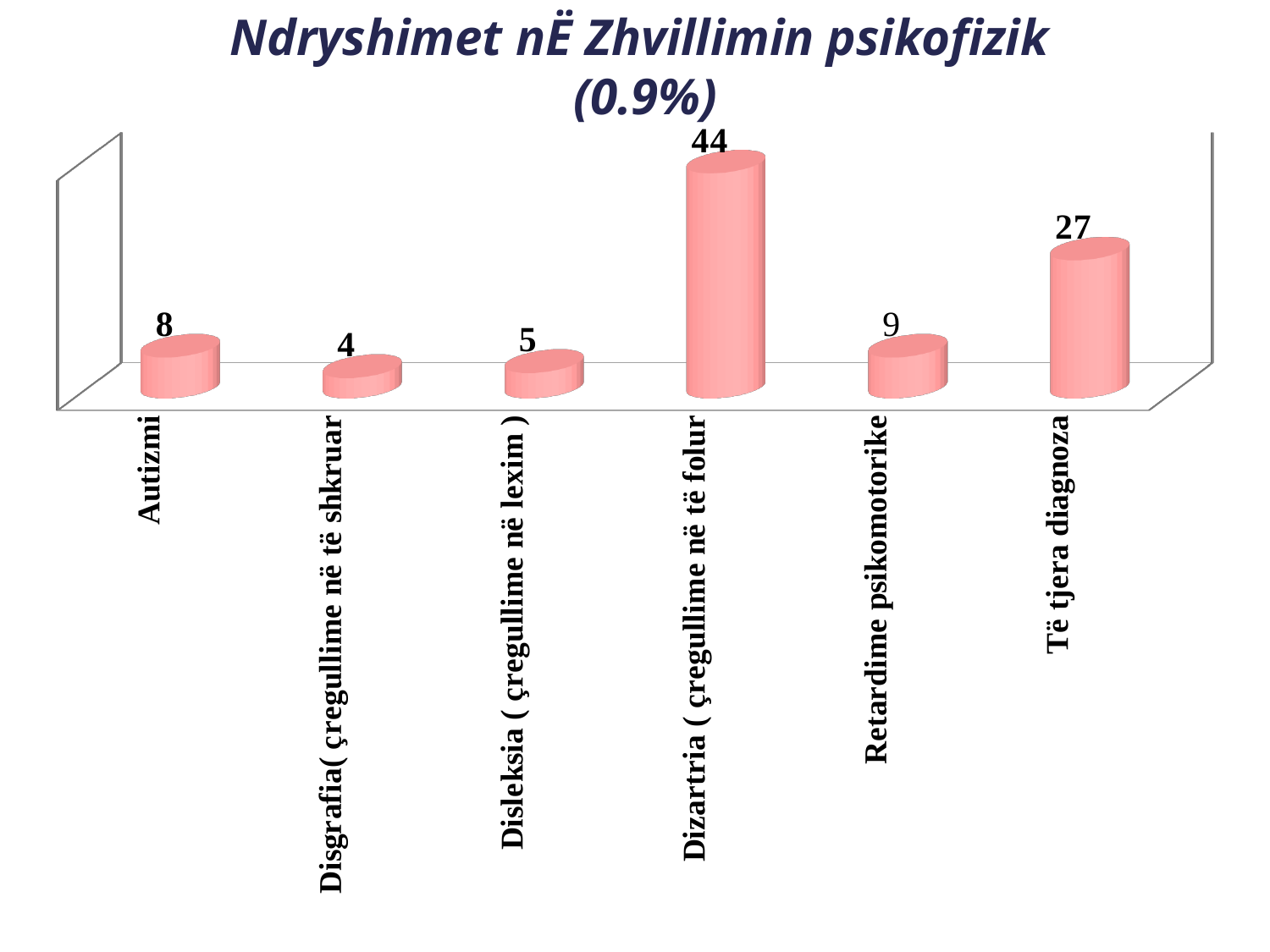
What is the value for Të tjera diagnoza? 27 What is the difference between the values for Retardime psikomotorike and Disleksia? 4 Which is larger, the value for Autizmi or the value for Disleksia ( çregullime në lexim )? Autizmi What is the value for Dizartria ( çregullime në të folur)? 44 What kind of chart is this? bar chart What is the value for Retardime psikomotorike? 9 What is the title of the chart? Ndryshimet nË Zhvillimin psikofizik (0.9%) What is the difference between the values for Dizartria and Të tjera diagnoza? 17 Which category has the lowest value? Disgrafia( çregullime në të shkruar) Which category has the highest value? Dizartria ( çregullime në të folur) What is the value for Autizmi? 8 How many categories are shown in the chart? 6